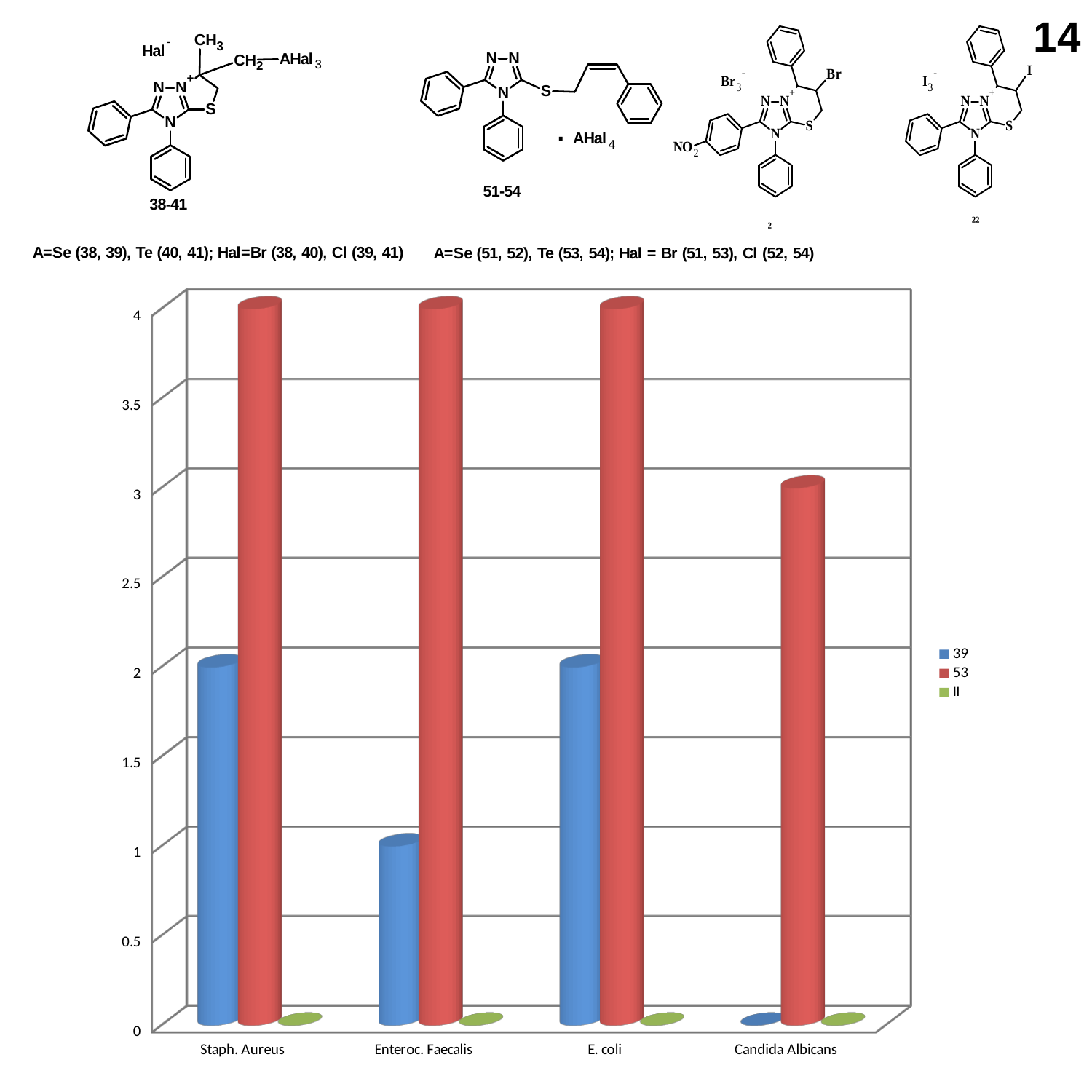
How many series does the chart legend list? 3 What is the value for series 53 for Staph. Aureus? 4 For which category is the value of series 53 lowest? Candida Albicans Which series does the red bar represent in the chart? 53 What is the value for series 39 for Enteroc. Faecalis? 1 Is the value for series 39 for Staph. Aureus greater or less than 3? less What is the value for series 39 for E. coli? 2 What is the value for series 53 for Candida Albicans? 3 How many categories are shown on the x axis of the chart? 4 For which category is the value of series 39 lowest? Candida Albicans What kind of chart is shown on the slide? bar chart Which is larger for Enteroc. Faecalis: the value for series 39 or the value for series 53? 53